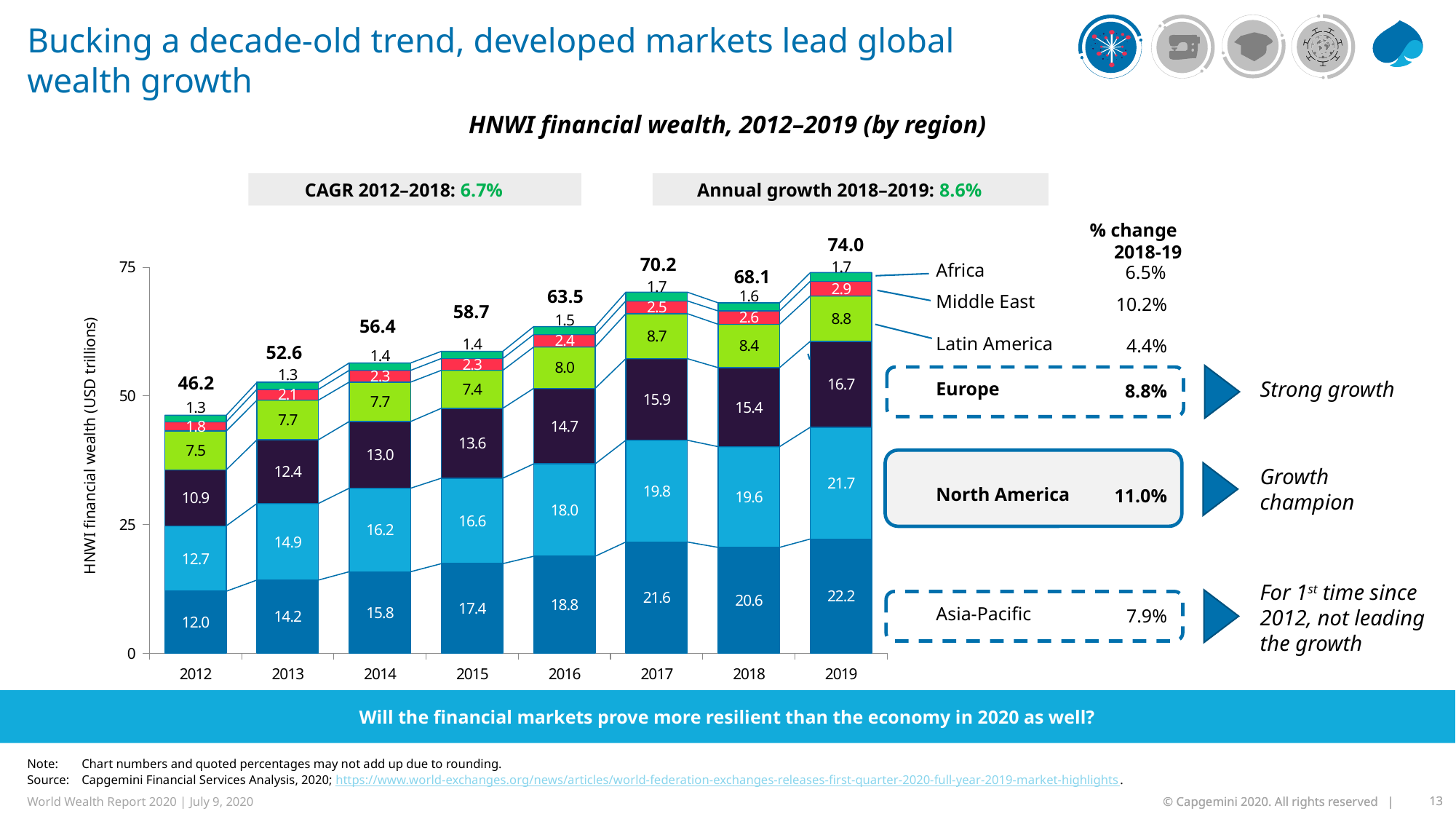
What is the value for Europe in 2015? 13.6 How many years are shown on the x axis of the chart? 8 Which year has the highest total HNWI financial wealth? 2019 What is the total HNWI financial wealth shown for 2019? 74.0 In 2018, which is larger: the value for Asia-Pacific or the value for North America? Asia-Pacific What is the CAGR for 2012–2018 stated above the chart? 6.7% How many regions (series) are stacked in each bar of the chart? 6 What is the value for Latin America in 2016? 8.0 What kind of chart is shown on the slide? Stacked bar chart What is the difference between the total for 2019 and the total for 2018? 5.9 What is the value for North America in 2017? 19.8 Which year has the lowest total HNWI financial wealth? 2012